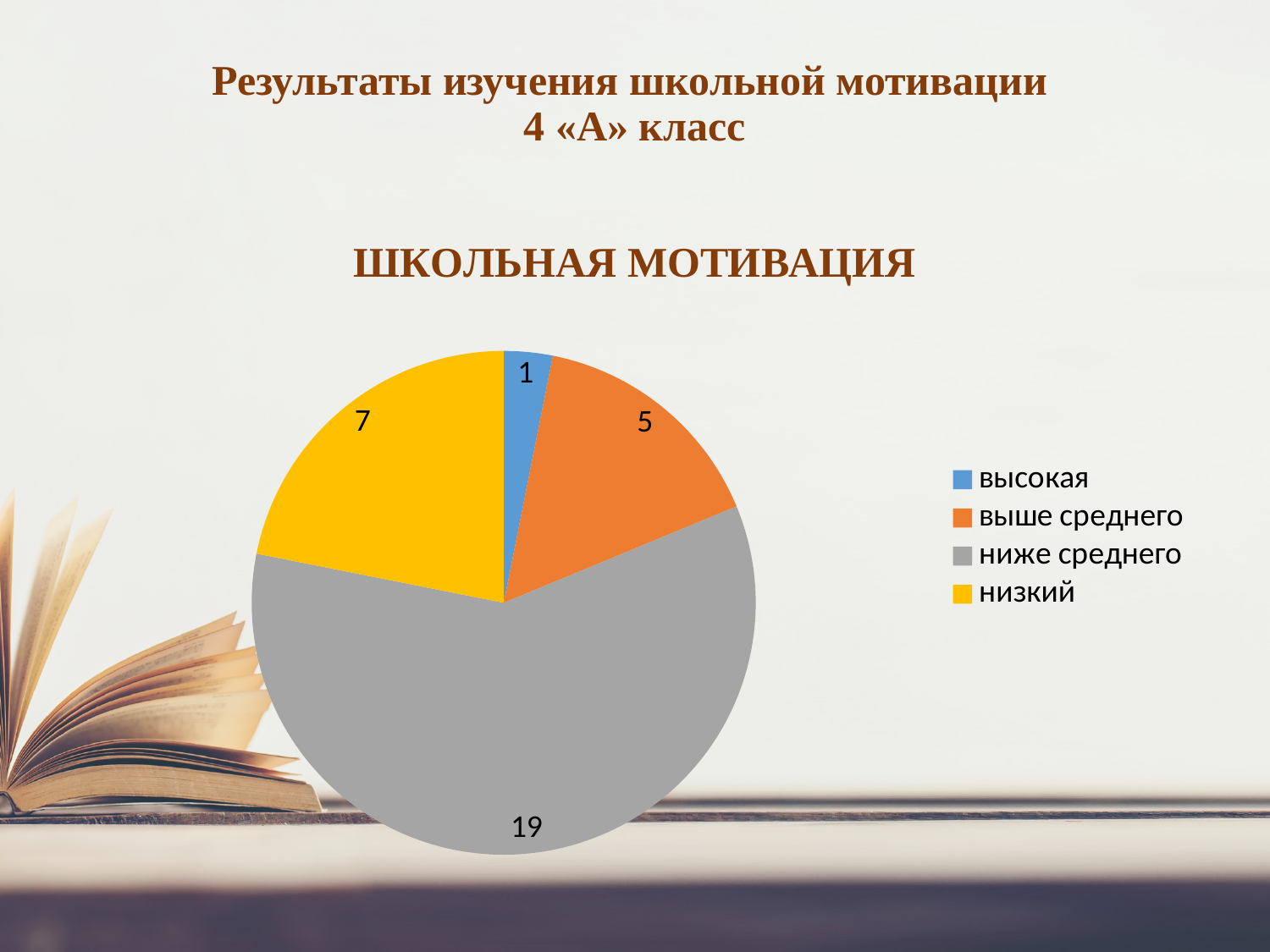
What is the value for the category "низкий"? 7 What is the difference between the values for "ниже среднего" and "низкий"? 12 Which category has the largest slice of the pie? ниже среднего What is the title of the chart? ШКОЛЬНАЯ МОТИВАЦИЯ How many categories does the legend of the chart list? 4 What is the value for the category "выше среднего"? 5 What type of chart is shown on the slide? pie chart Which category has the smallest slice of the pie? высокая What is the total of all the values shown in the pie chart? 32 What is the value for the category "ниже среднего"? 19 What is the value for the category "высокая"? 1 Which is larger, the value for "низкий" or the value for "выше среднего"? низкий